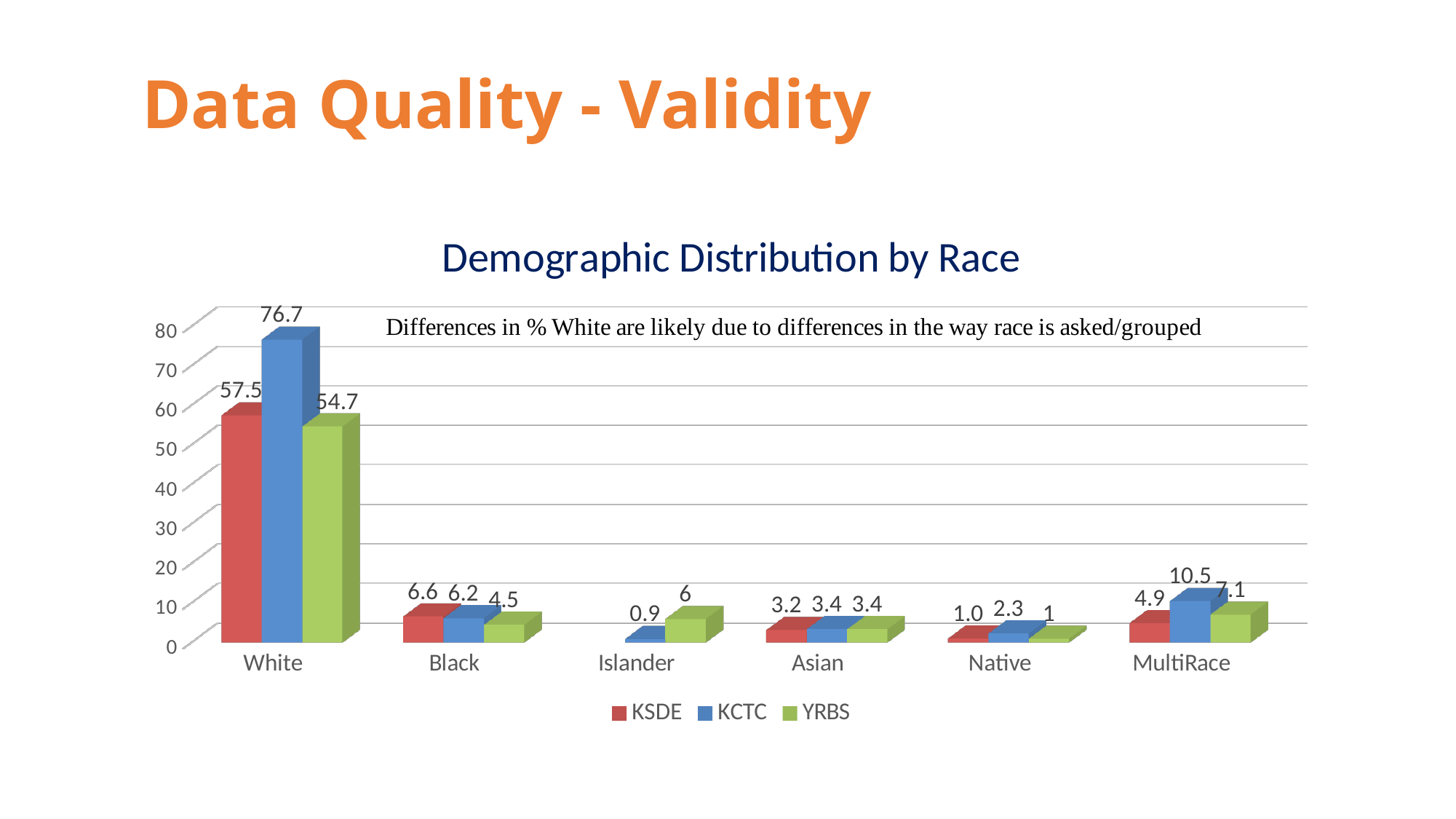
What is the KCTC value for Native? 2.3 What is the KCTC value for White? 76.7 How many series does the legend list? 3 Which race category has the lowest KCTC value? Islander What is the YRBS value for Islander? 6 What kind of chart is shown? Bar chart What is the difference between the KCTC and KSDE values for White? 19.2 What is the KSDE value for MultiRace? 4.9 Which is larger for Black, the KSDE value or the YRBS value? KSDE Which race category has the highest KSDE value? White How many race categories are shown on the x axis? 6 What is the title of the chart? Demographic Distribution by Race